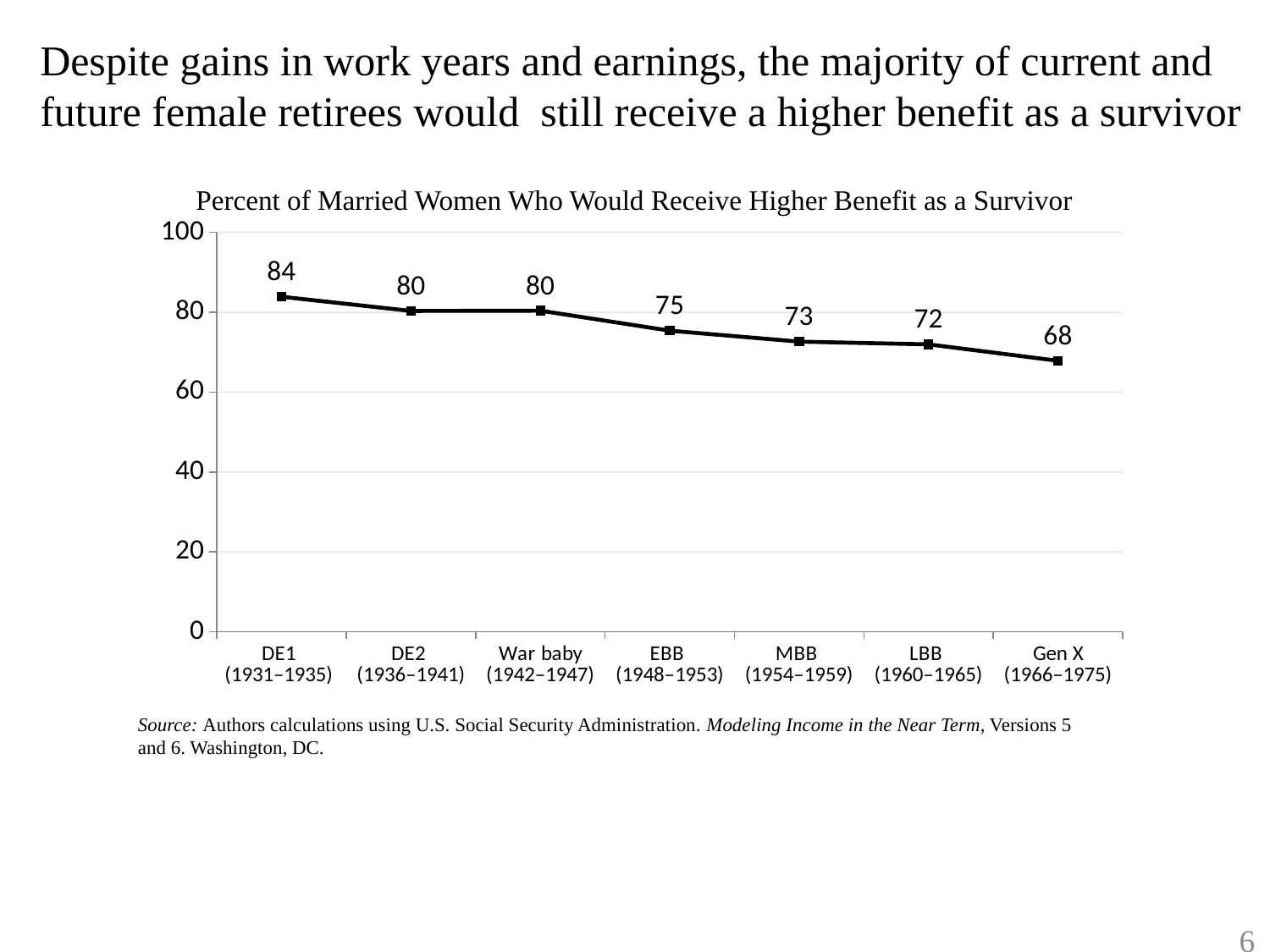
What is the difference between the values for DE1 (1931–1935) and Gen X (1966–1975)? 16 What is the value for EBB (1948–1953)? 75 Which cohort has the highest value? DE1 (1931–1935) Is the value for LBB (1960–1965) greater or less than 80? less What is the title of the chart? Percent of Married Women Who Would Receive Higher Benefit as a Survivor How many cohorts are plotted on the chart? 7 Which cohort has the lowest value? Gen X (1966–1975) Do the values rise or fall from DE1 to Gen X along the x axis? fall Which is larger, the value for MBB (1954–1959) or the value for War baby (1942–1947)? War baby (1942–1947) What is the value for Gen X (1966–1975)? 68 What kind of chart is shown on the slide? line chart What is the value for DE1 (1931–1935)? 84